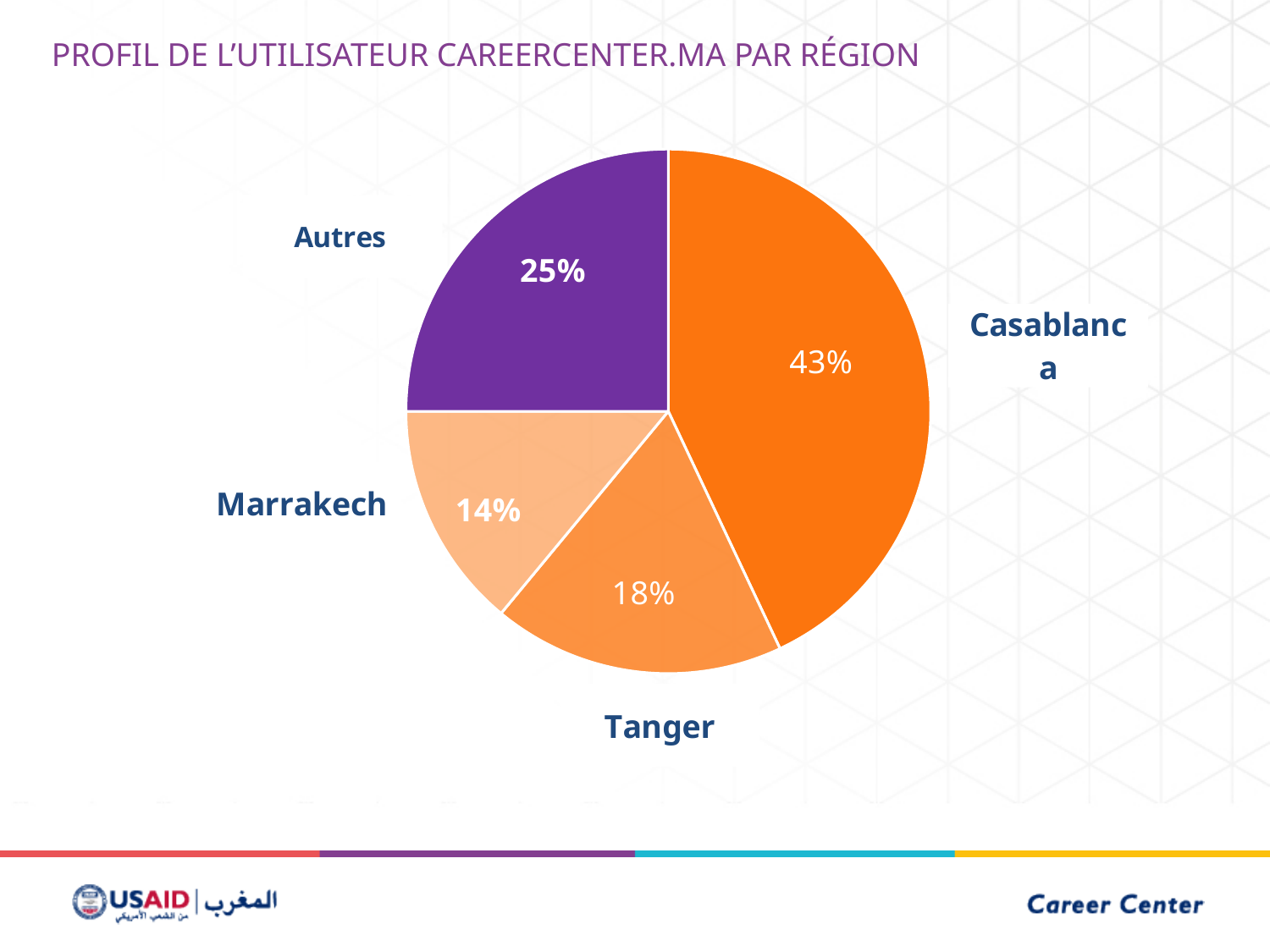
What share of CareerCenter.ma users is from Casablanca? 43% How many slices does the pie chart have? 4 What is the title of the slide? PROFIL DE L'UTILISATEUR CAREERCENTER.MA PAR RÉGION Which region has the largest share of users? Casablanca What is the difference in percentage points between Tanger and Marrakech? 4 Which has a larger share, Tanger or Autres? Autres What is the difference in percentage points between Casablanca and Autres? 18 What share of users is from Marrakech? 14% What share of users is from Tanger? 18% Which region has the smallest share of users? Marrakech What share of users falls under Autres? 25% What kind of chart is shown on the slide? Pie chart